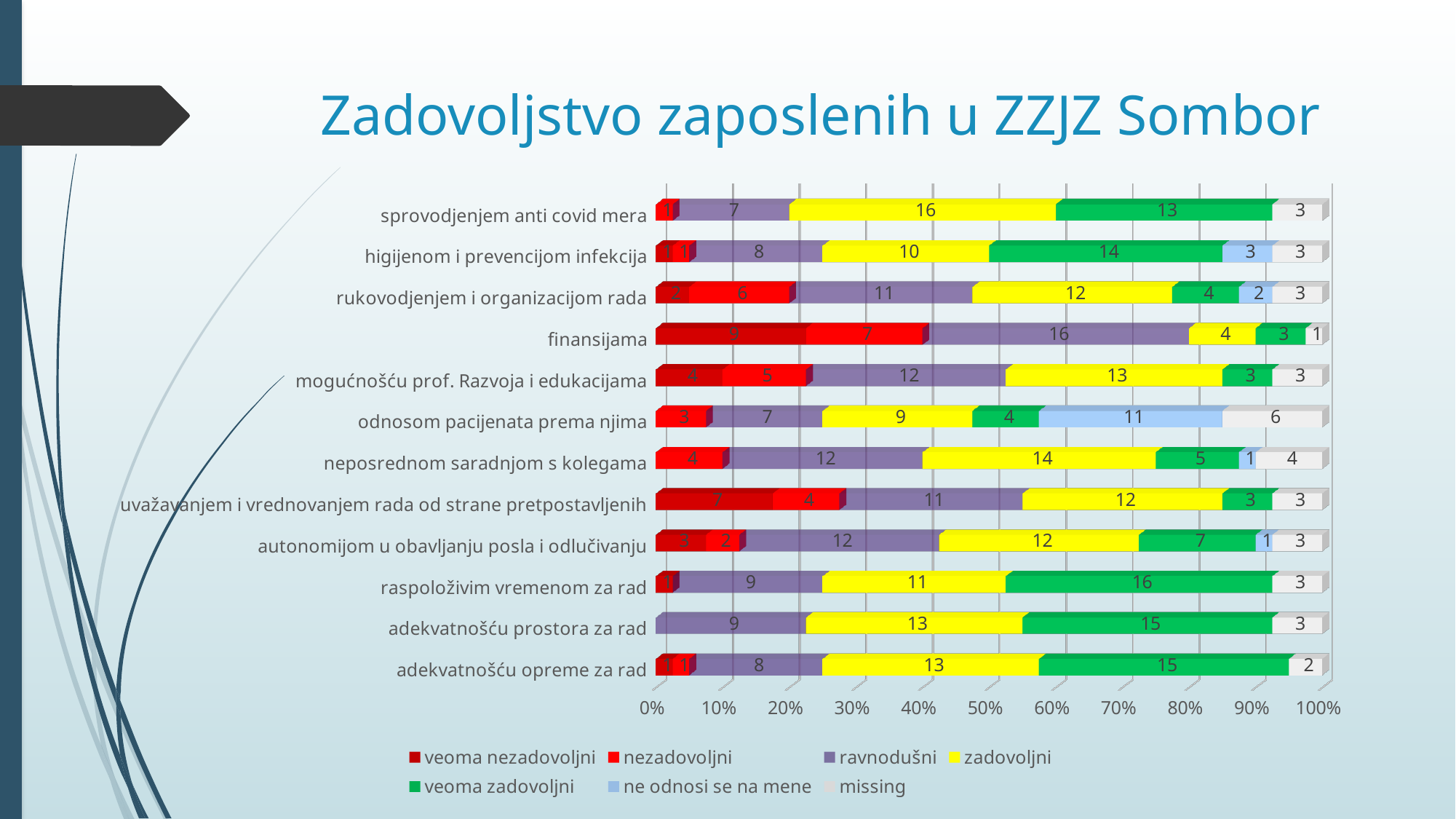
Which is larger: the 'veoma zadovoljni' value for 'higijenom i prevencijom infekcija' or for 'rukovodjenjem i organizacijom rada'? higijenom i prevencijom infekcija What is the total of all segments in the bar for 'adekvatnošću prostora za rad'? 40 Which category has the highest 'veoma zadovoljni' value? raspoloživim vremenom za rad How many series does the legend list? 7 How many categories are listed on the vertical axis of the chart? 12 What is the value of 'zadovoljni' for 'sprovodjenjem anti covid mera'? 16 What is the difference between the 'ravnodušni' values for 'finansijama' and 'sprovodjenjem anti covid mera'? 9 What is the title of the chart? Zadovoljstvo zaposlenih u ZZJZ Sombor Which category has the lowest 'missing' value? finansijama What is the value of 'veoma nezadovoljni' for 'finansijama'? 9 What is the value of 'ne odnosi se na mene' for 'odnosom pacijenata prema njima'? 11 What type of chart is shown on the slide? stacked bar chart